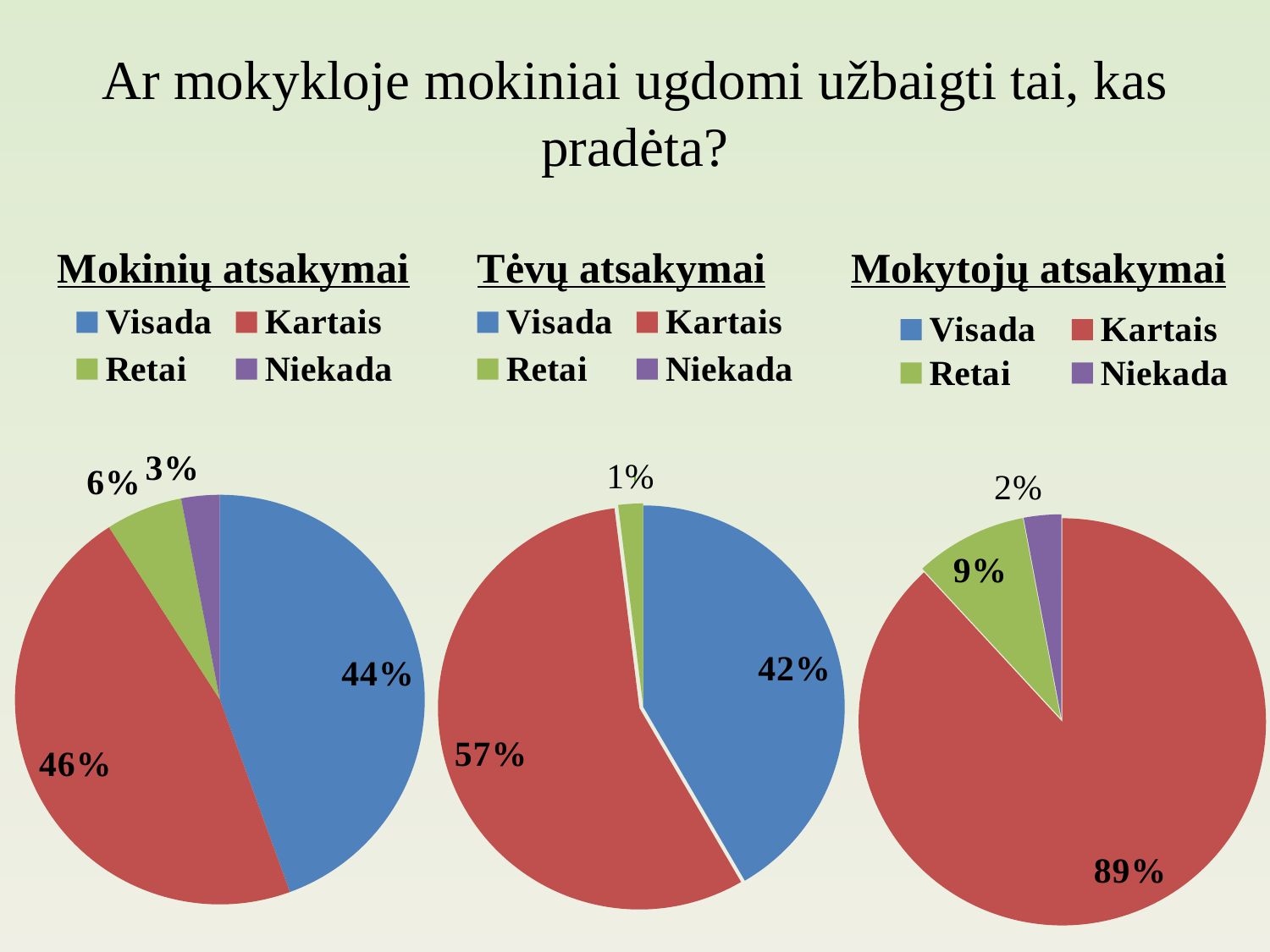
In the 'Tėvų atsakymai' chart, what percentage is shown for Retai? 1% In the 'Mokinių atsakymai' chart, what percentage is shown for Kartais? 46% In the 'Mokytojų atsakymai' chart, what percentage is shown for Kartais? 89% How many entries does the legend of the 'Mokinių atsakymai' chart list? 4 In the 'Mokytojų atsakymai' chart, what percentage is shown for Retai? 9% In the 'Mokinių atsakymai' chart, what percentage is shown for Visada? 44% What type of chart is used for 'Tėvų atsakymai'? Pie chart In the 'Tėvų atsakymai' chart, what percentage is shown for Kartais? 57% In the 'Mokinių atsakymai' chart, which category has the smallest share? Niekada In the 'Mokytojų atsakymai' chart, which category has the largest share? Kartais In the 'Mokinių atsakymai' chart, what is the difference between the Retai and Niekada shares? 3% In the 'Tėvų atsakymai' chart, which is larger, Visada or Kartais? Kartais